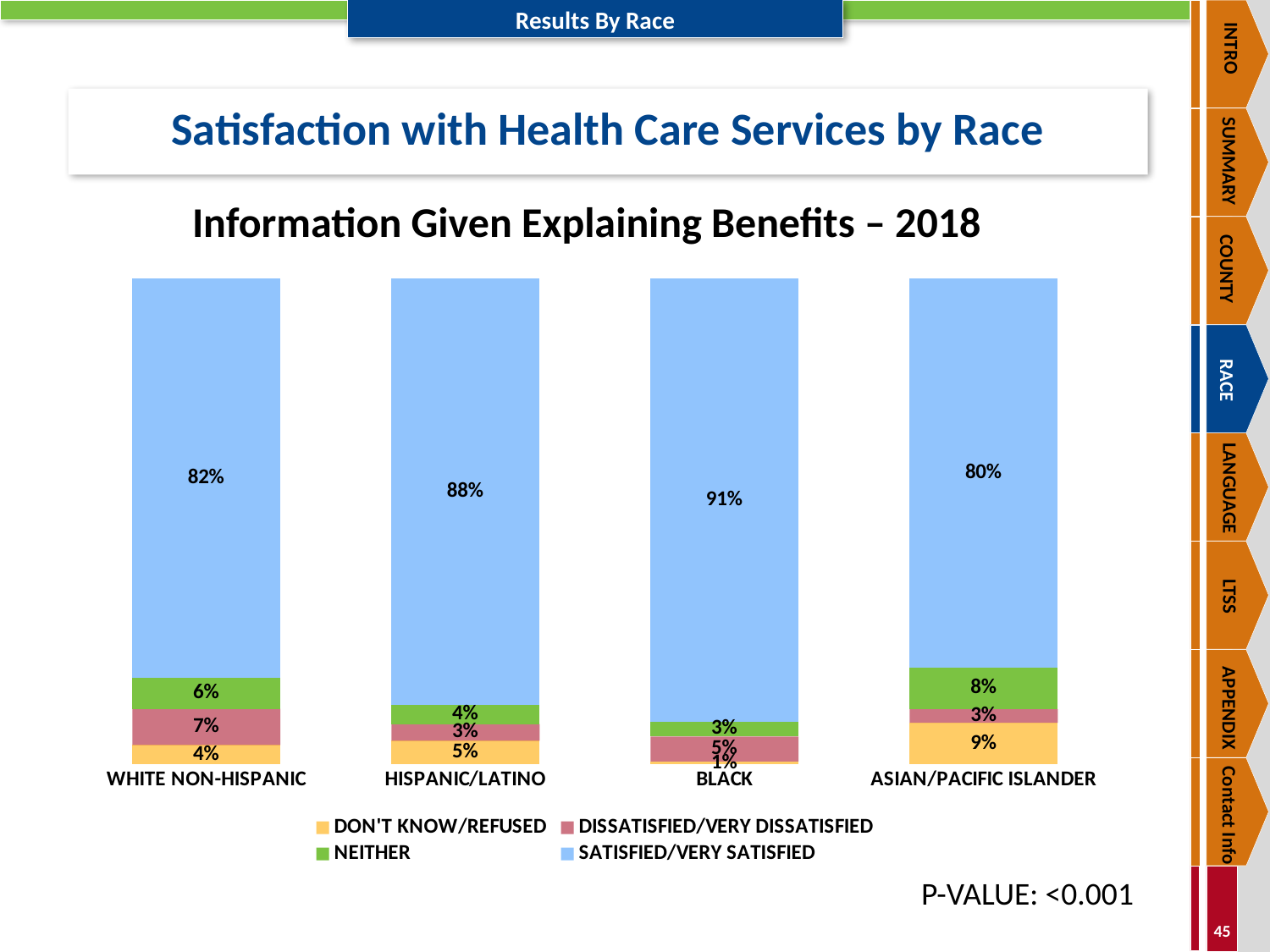
Which race group has the highest Satisfied/Very Satisfied percentage? Black Which is larger: the Neither value for Asian/Pacific Islander or the Neither value for Black? Asian/Pacific Islander What percentage of Black respondents were Satisfied/Very Satisfied with the information given explaining benefits? 91% What kind of chart is shown on the slide? Stacked bar chart What is the Neither value for Hispanic/Latino respondents? 4% How many race groups are shown on the x axis of the chart? 4 What is the Don't Know/Refused value for Asian/Pacific Islander respondents? 9% What is the difference between the Satisfied/Very Satisfied percentages for Hispanic/Latino and White Non-Hispanic respondents? 6% Which race group has the lowest Satisfied/Very Satisfied percentage? Asian/Pacific Islander What is the total of the stacked bar for Black respondents? 100% How many series does the legend list? 4 What is the Dissatisfied/Very Dissatisfied value for White Non-Hispanic respondents? 7%